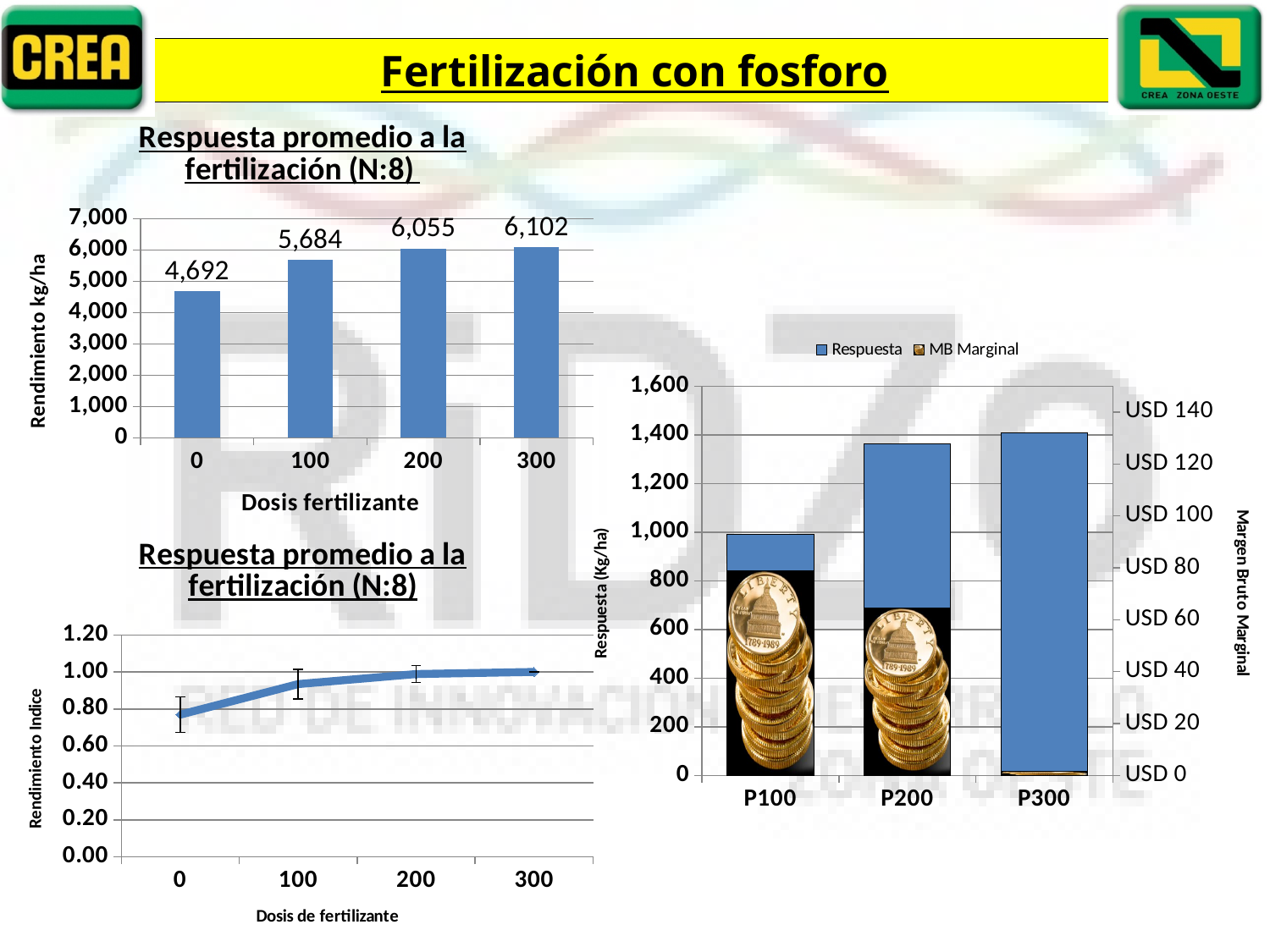
In the top-left bar chart, what is the yield for a fertilizer dose of 200? 6,055 In the right-hand chart, which category has the lowest Respuesta value? P100 In the top-left bar chart, which fertilizer dose has the highest yield? 300 In the top-left bar chart, what is the difference in yield between dose 100 and dose 0? 992 In the top-left bar chart, how many fertilizer doses are shown? 4 In the top-left bar chart, which fertilizer dose has the lowest yield? 0 In the right-hand chart, is the Respuesta value for P300 greater or less than 1,200? greater In the top-left bar chart, what is the yield (Rendimiento kg/ha) for a fertilizer dose of 0? 4,692 What kind of chart is the bottom-left chart titled 'Respuesta promedio a la fertilización (N:8)' with the Rendimiento Indice axis? line chart How many series does the legend of the right-hand chart list? 2 In the top-left bar chart, do yields rise or fall as the fertilizer dose increases? rise In the bottom-left line chart, is the Rendimiento Indice value at dose 0 greater or less than 0.60? greater